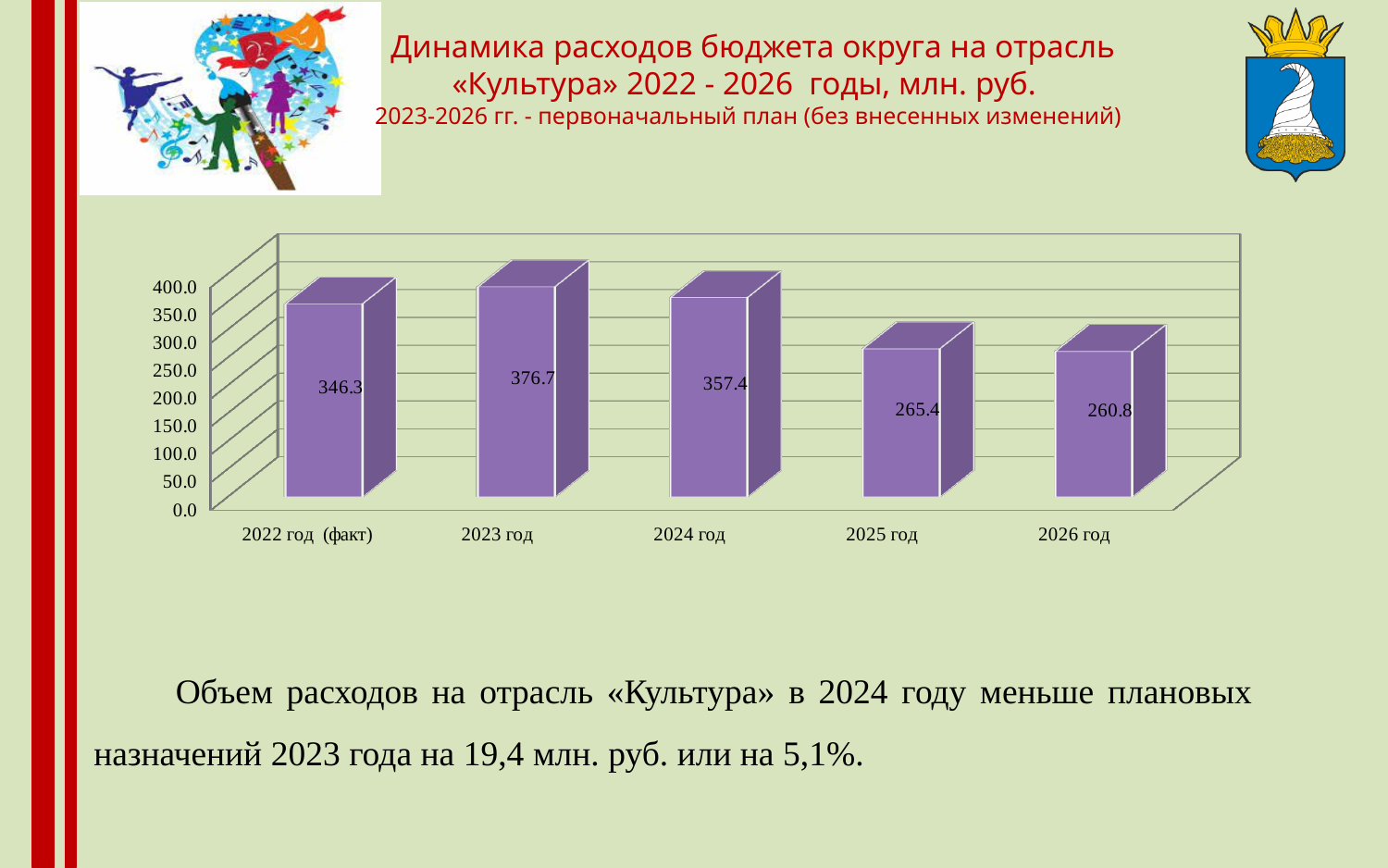
What is the difference between the values for 2023 год and 2025 год? 111.3 Do the values rise or fall from 2024 год to 2026 год? fall Which year has the lowest value? 2026 год What kind of chart is shown on the slide? bar chart What is the value for 2026 год? 260.8 What is the difference between the values for 2022 год (факт) and 2026 год? 85.5 What is the value for 2022 год (факт)? 346.3 Which is larger, the value for 2024 год or the value for 2025 год? 2024 год What is the value for 2023 год? 376.7 How many years are shown on the x axis? 5 Which year has the highest value? 2023 год Is the value for 2025 год greater or less than 300.0? less